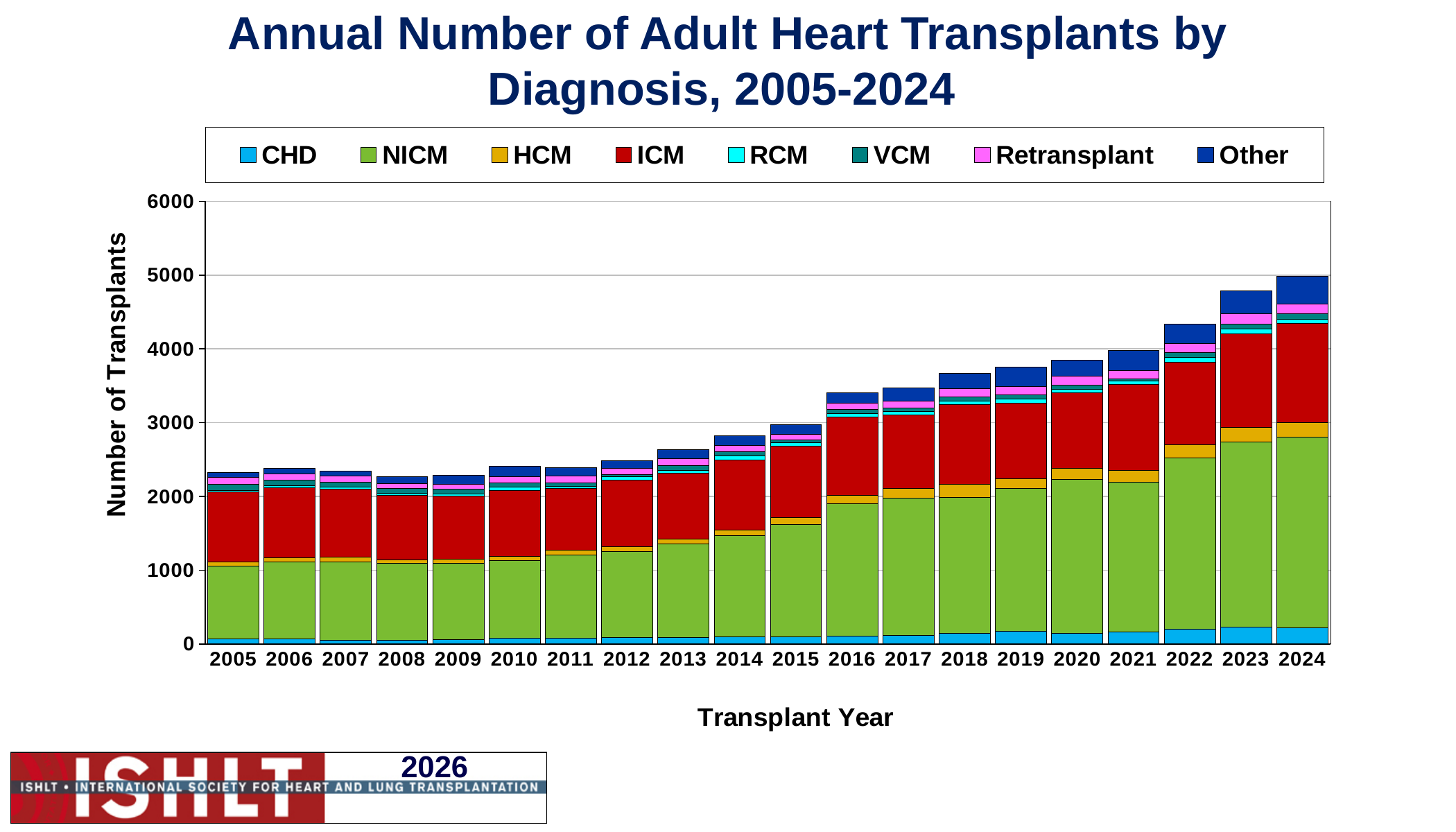
What kind of chart is shown on the slide? Stacked bar chart Overall, do the total annual transplant numbers rise or fall from 2005 to 2024? rise Is the total number of transplants in 2005 greater or less than 3000? less Which transplant year has the highest total number of transplants? 2024 Is the total number of transplants in 2016 greater or less than 3000? greater Which colour represents ICM in the legend? Red How many transplant years are shown along the x axis? 20 Is the total number of transplants in 2013 greater or less than 3000? less Which year has a larger total number of transplants, 2005 or 2024? 2024 What is the title of the y axis? Number of Transplants How many diagnosis series does the legend list? 8